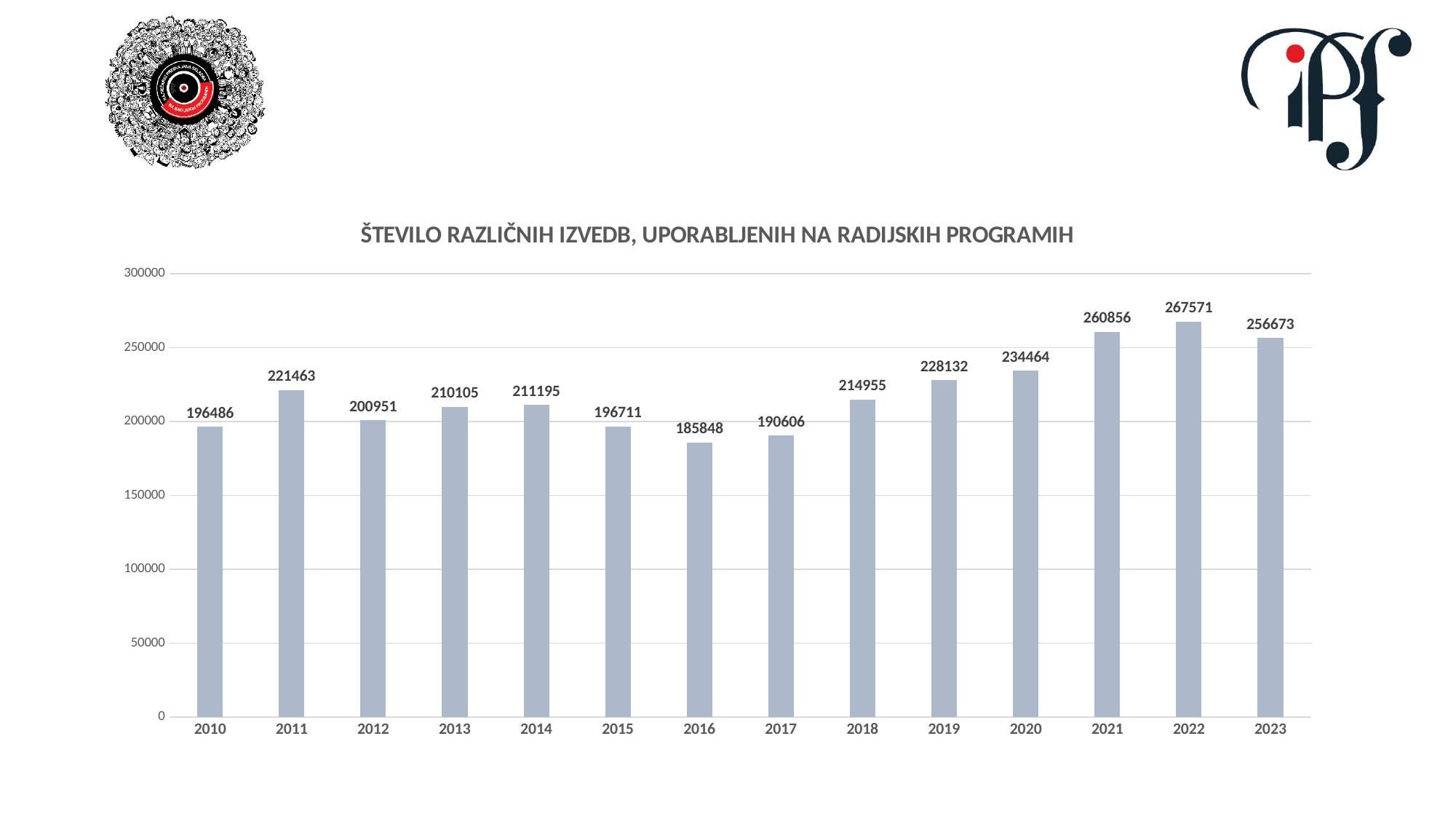
Which year has the lowest value? 2016 What is the value for 2010? 196486 What is the difference between the values for 2022 and 2016? 81723 Which is larger, the value for 2014 or the value for 2015? 2014 How many years are shown on the x axis? 14 What kind of chart is shown on the slide? bar chart What is the value for 2016? 185848 What is the difference between the values for 2022 and 2023? 10898 Is the value for 2019 greater or less than 200000? greater What is the value for 2021? 260856 Which year has the highest value? 2022 What is the title of the chart? ŠTEVILO RAZLIČNIH IZVEDB, UPORABLJENIH NA RADIJSKIH PROGRAMIH